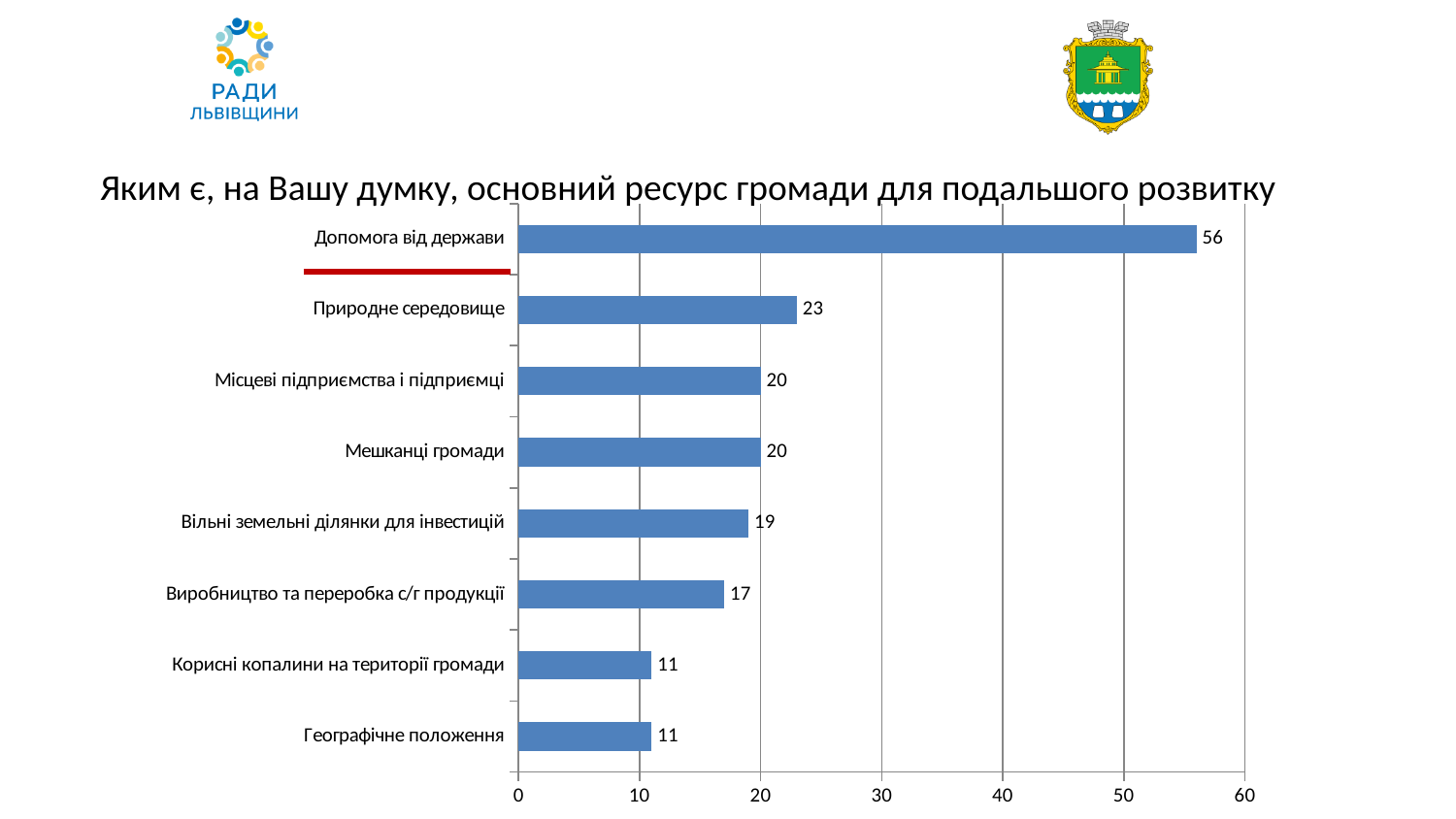
What is the difference between the values for "Допомога від держави" and "Природне середовище"? 33 What kind of chart is shown on the slide? bar chart Is the value for "Допомога від держави" greater or less than 50? greater What is the value for "Допомога від держави"? 56 What is the title of the chart? Яким є, на Вашу думку, основний ресурс громади для подальшого розвитку How many categories are shown in the chart? 8 What is the value for "Вільні земельні ділянки для інвестицій"? 19 Which category has the highest value? Допомога від держави What is the value for "Виробництво та переробка с/г продукції"? 17 What is the value for "Географічне положення"? 11 What is the value for "Природне середовище"? 23 Which is larger, the value for "Мешканці громади" or the value for "Корисні копалини на території громади"? Мешканці громади